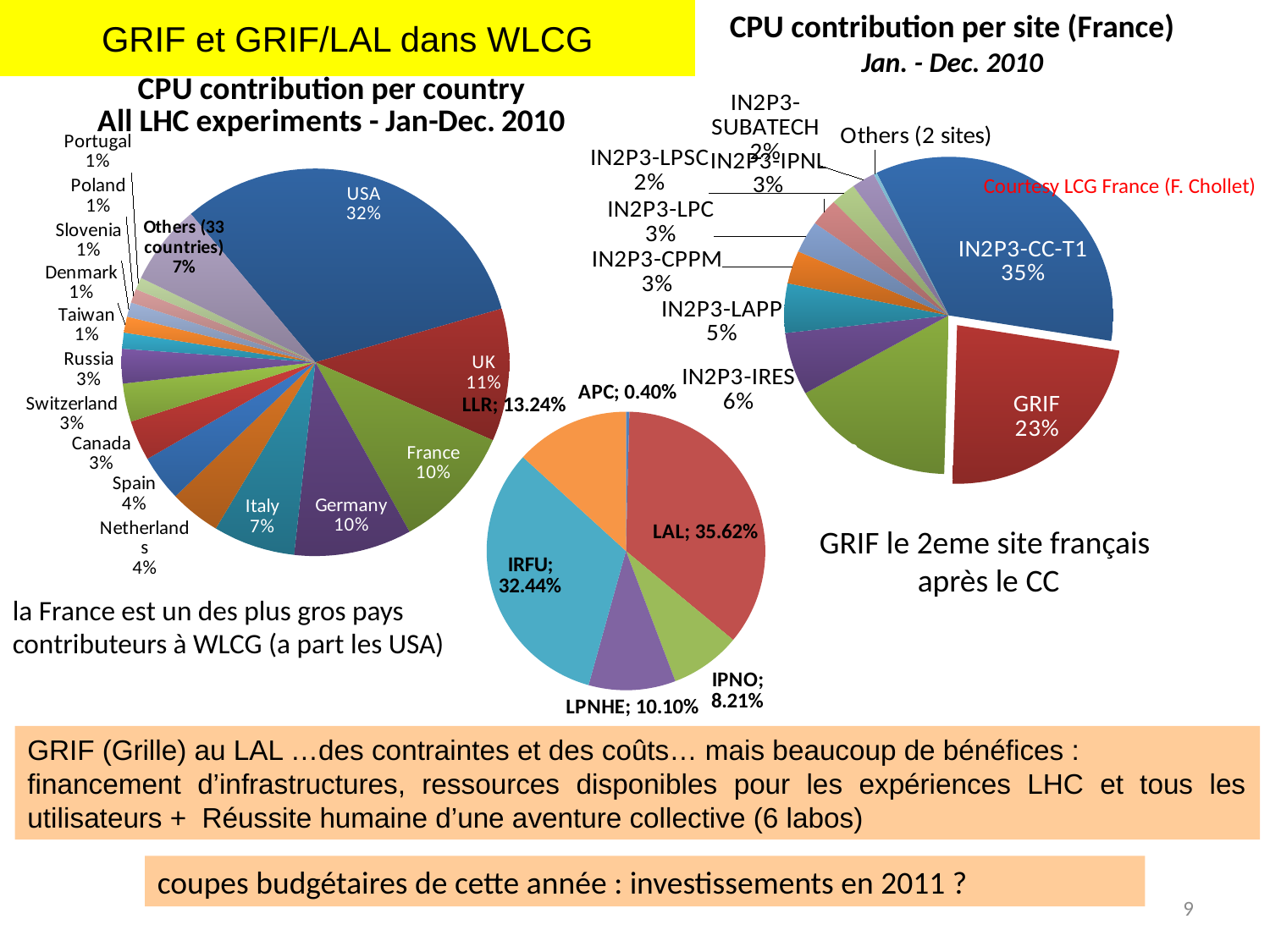
In the 'CPU contribution per site (France)' chart, which site has the largest share? IN2P3-CC-T1 In the bottom-middle pie chart, what share does LAL have? 35.62% In the 'CPU contribution per site (France)' chart, what share does GRIF have? 23% In the bottom-middle pie chart, how many labs are shown? 6 What type of chart is the 'CPU contribution per site (France)' chart? Pie chart In the 'CPU contribution per country' chart, what share does the USA have? 32% In the 'CPU contribution per country' chart, which country has the largest share? USA In the 'CPU contribution per site (France)' chart, what is the difference between IN2P3-CC-T1 and GRIF? 12% In the 'CPU contribution per country' chart, what share is attributed to 'Others (33 countries)'? 7% In the bottom-middle pie chart, which lab has the smallest share? APC In the 'CPU contribution per country' chart, what is the difference between the UK's share and France's share? 1% In the 'CPU contribution per site (France)' chart, which is larger: IN2P3-IRES or IN2P3-LAPP? IN2P3-IRES